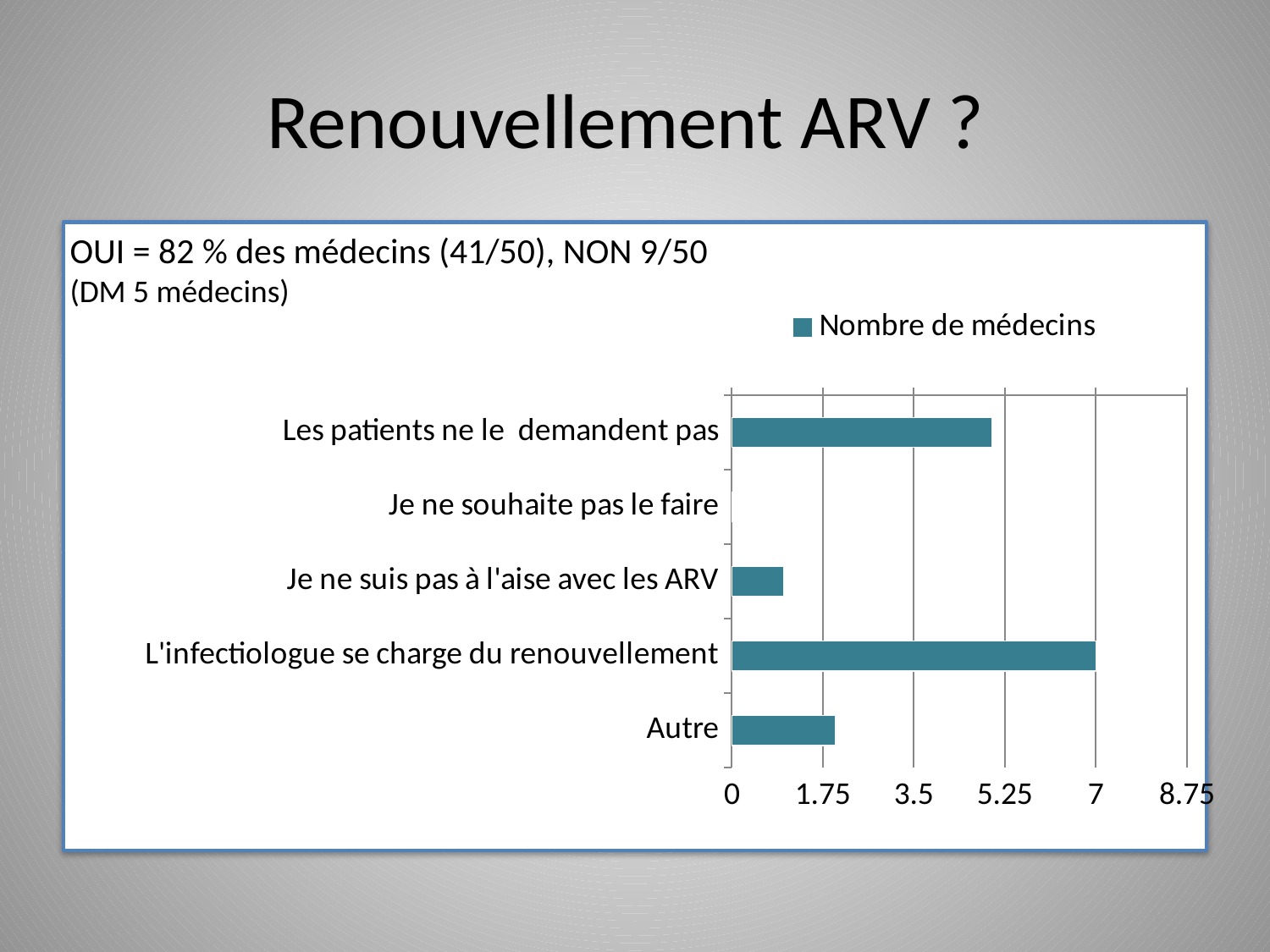
Is the value for 'Les patients ne le demandent pas' greater or less than 5.25? less Is the value for 'Je ne suis pas à l'aise avec les ARV' greater or less than 1.75? less Is the value for 'Autre' greater or less than 1.75? greater What is the value for 'L'infectiologue se charge du renouvellement'? 7 How many series does the legend list? 1 Which is larger, the value for 'Les patients ne le demandent pas' or the value for 'Autre'? Les patients ne le demandent pas What is the name of the series shown in the legend? Nombre de médecins What kind of chart is shown on the slide? bar chart How many categories are plotted in the chart? 5 Which category has the lowest value? Je ne souhaite pas le faire Which category has the highest value? L'infectiologue se charge du renouvellement